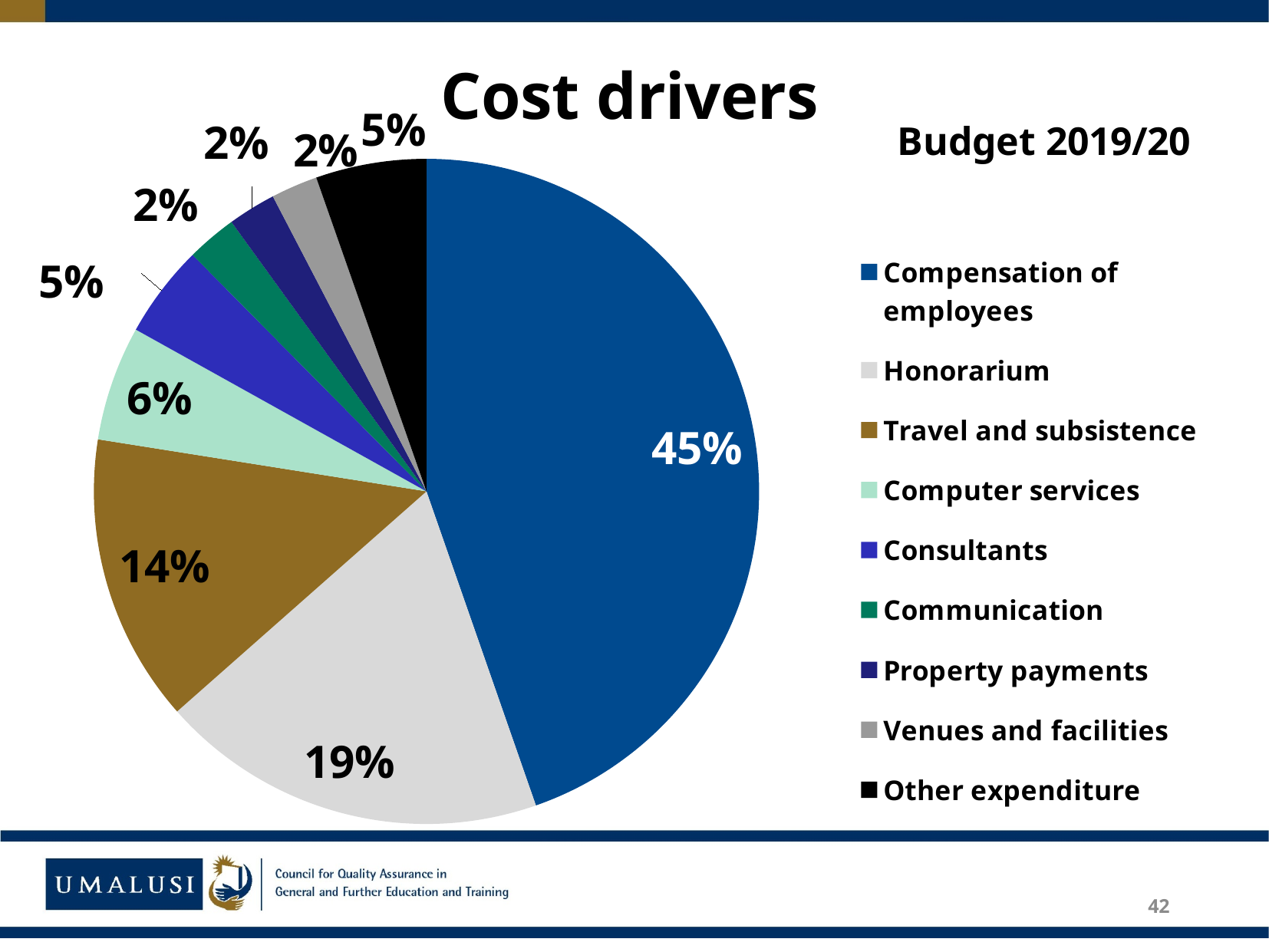
What kind of chart is shown on the slide? Pie chart Which category has the largest share of the pie? Compensation of employees What share of the budget is Other expenditure? 5% Which is larger, the share for Computer services or the share for Consultants? Computer services How many categories does the legend list? 9 What share of the budget is Travel and subsistence? 14% What share of the budget is Compensation of employees? 45% What is the title of the chart? Budget 2019/20 What is the difference between the Honorarium share and the Travel and subsistence share? 5% What share of the budget is Honorarium? 19% Which budget year does the chart refer to? Budget 2019/20 What share of the budget is Computer services? 6%